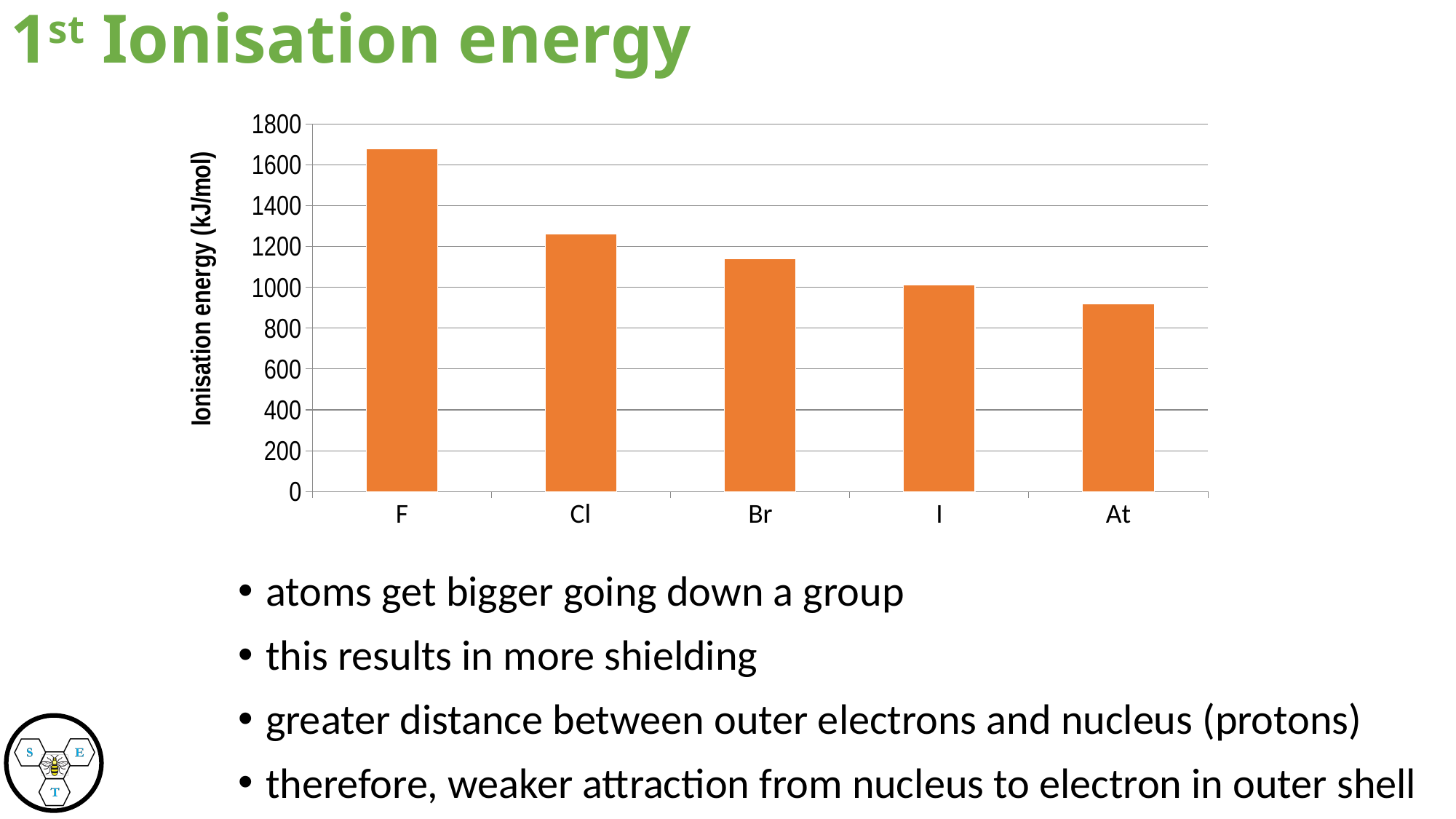
Which element has the highest 1st ionisation energy on the chart? F Is the value for Br greater or less than 1000? greater How many elements are plotted on the chart? 5 What is the label on the vertical axis of the chart? Ionisation energy (kJ/mol) Do the ionisation energy values rise or fall going from F to At along the x axis? fall Which element has the lowest 1st ionisation energy on the chart? At Is the value for Cl greater or less than 1200? greater What kind of chart is shown on the slide? bar chart Is the value for At greater or less than 1000? less Which has the larger ionisation energy, Br or I? Br Which has the larger ionisation energy, F or Cl? F